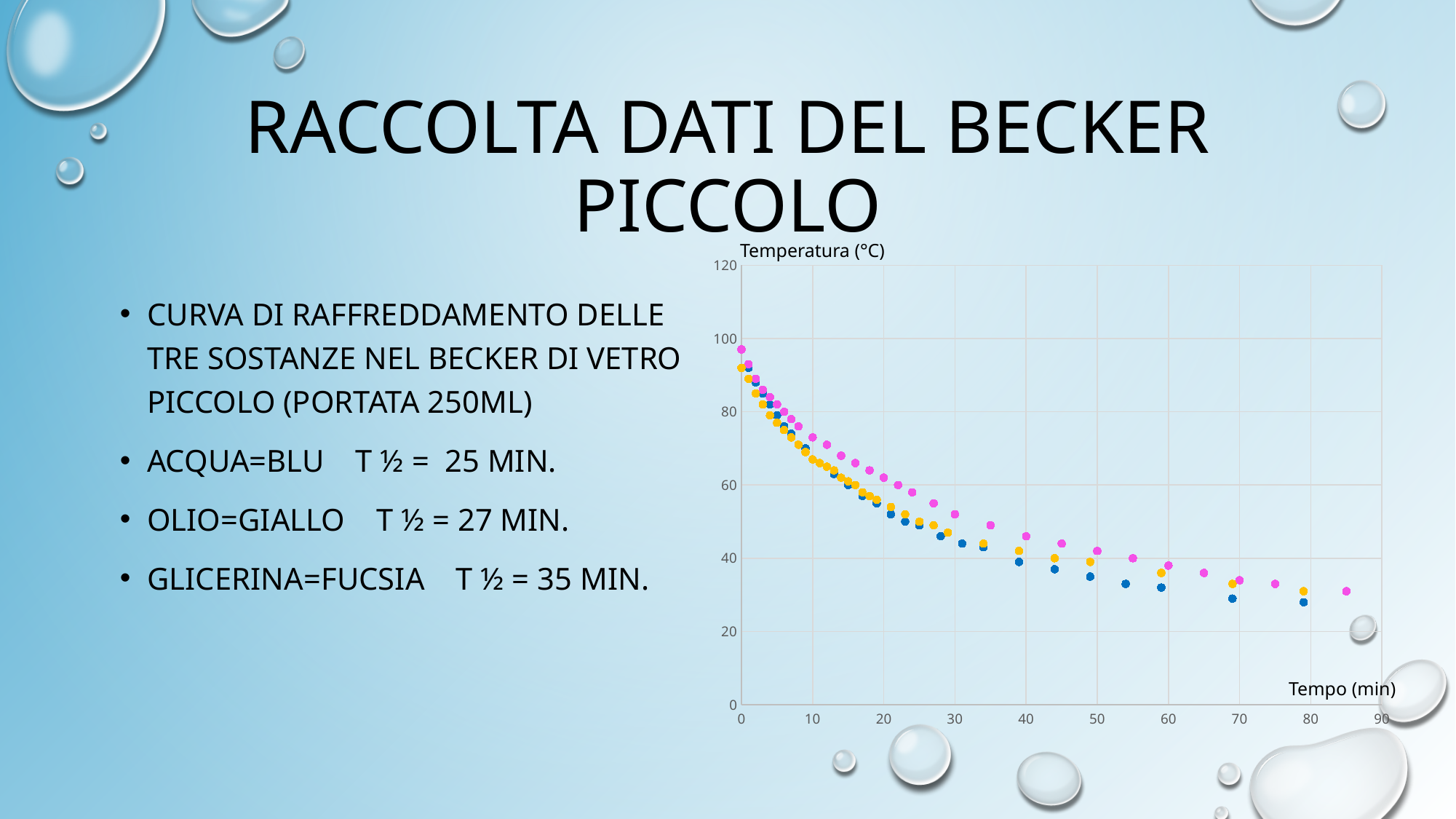
Is the temperature of the fuchsia (glicerina) series at its last point, around 85 min, greater or less than 40? less What is the label of the vertical axis of the chart? Temperatura (°C) Do the temperature values rise or fall as time increases along the x axis? fall Is the temperature of the blue (acqua) series at around 30 min greater or less than 60? less Is the temperature of the fuchsia (glicerina) series at around 30 min greater or less than 40? greater At around 30 min, which series shows the higher temperature, the fuchsia (glicerina) or the blue (acqua)? fuchsia (glicerina) How many series of points are plotted on the chart? 3 What kind of chart is shown on the slide? scatter chart What is the label of the horizontal axis of the chart? Tempo (min) Which series reaches the lowest temperature by the end of the measurement? blue (acqua)